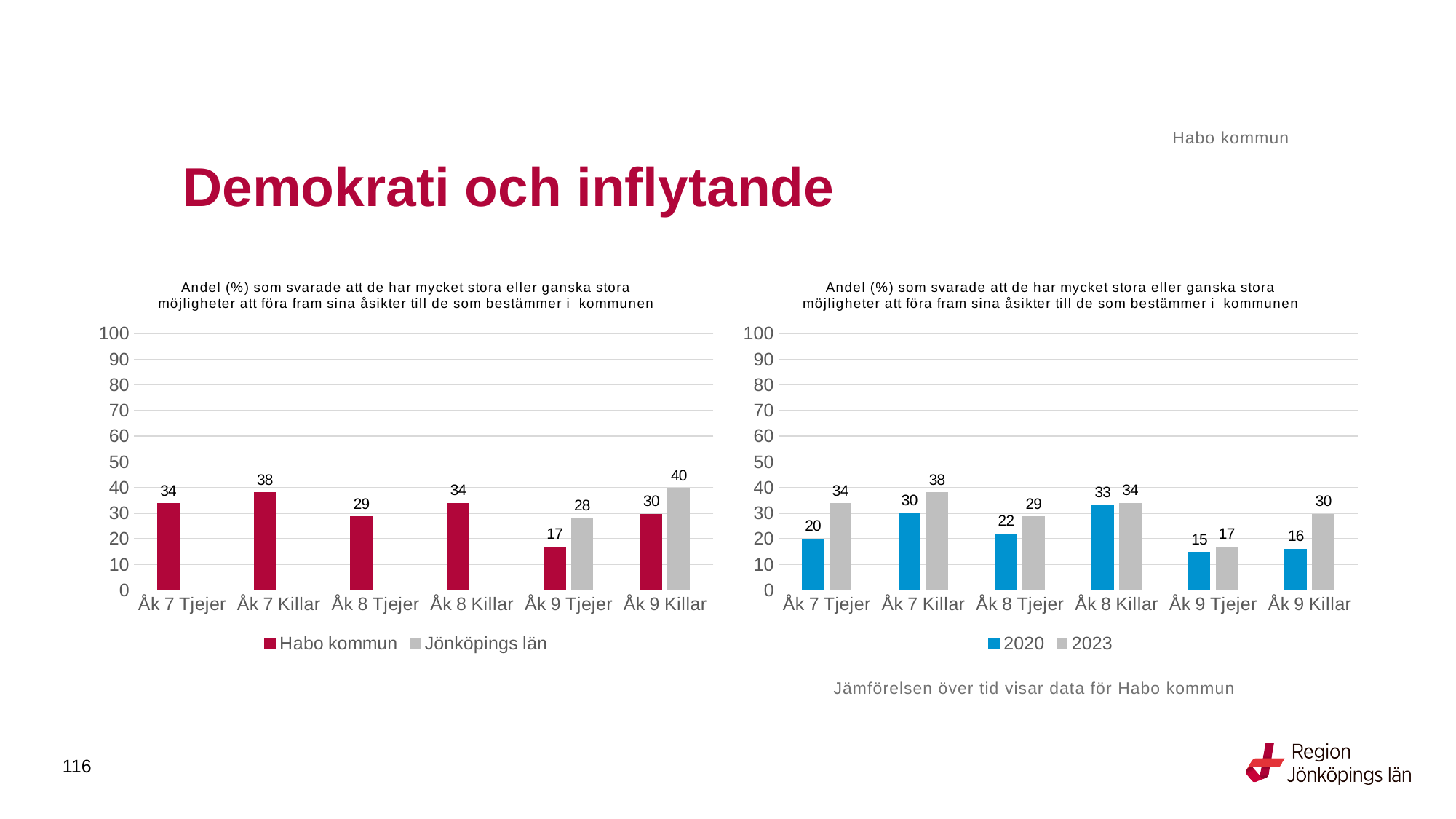
In the right chart, what is the value for 2023 for Åk 9 Tjejer? 17 How many categories are shown on the x axis of the right chart? 6 In the right chart, which category has the lowest value for 2020? Åk 9 Tjejer In the right chart, which is larger for Åk 7 Tjejer: the 2020 value or the 2023 value? 2023 In the left chart, what is the value for Jönköpings län for Åk 9 Killar? 40 In the right chart, what is the difference between 2023 and 2020 for Åk 9 Killar? 14 In the left chart, what is the difference between Jönköpings län and Habo kommun for Åk 9 Tjejer? 11 In the left chart, how many series does the legend list? 2 In the left chart, what is the value for Habo kommun for Åk 7 Killar? 38 In the right chart, which category has the highest value for 2023? Åk 7 Killar In the right chart, what is the value for 2020 for Åk 8 Killar? 33 In the left chart, which category has the lowest value for Habo kommun? Åk 9 Tjejer